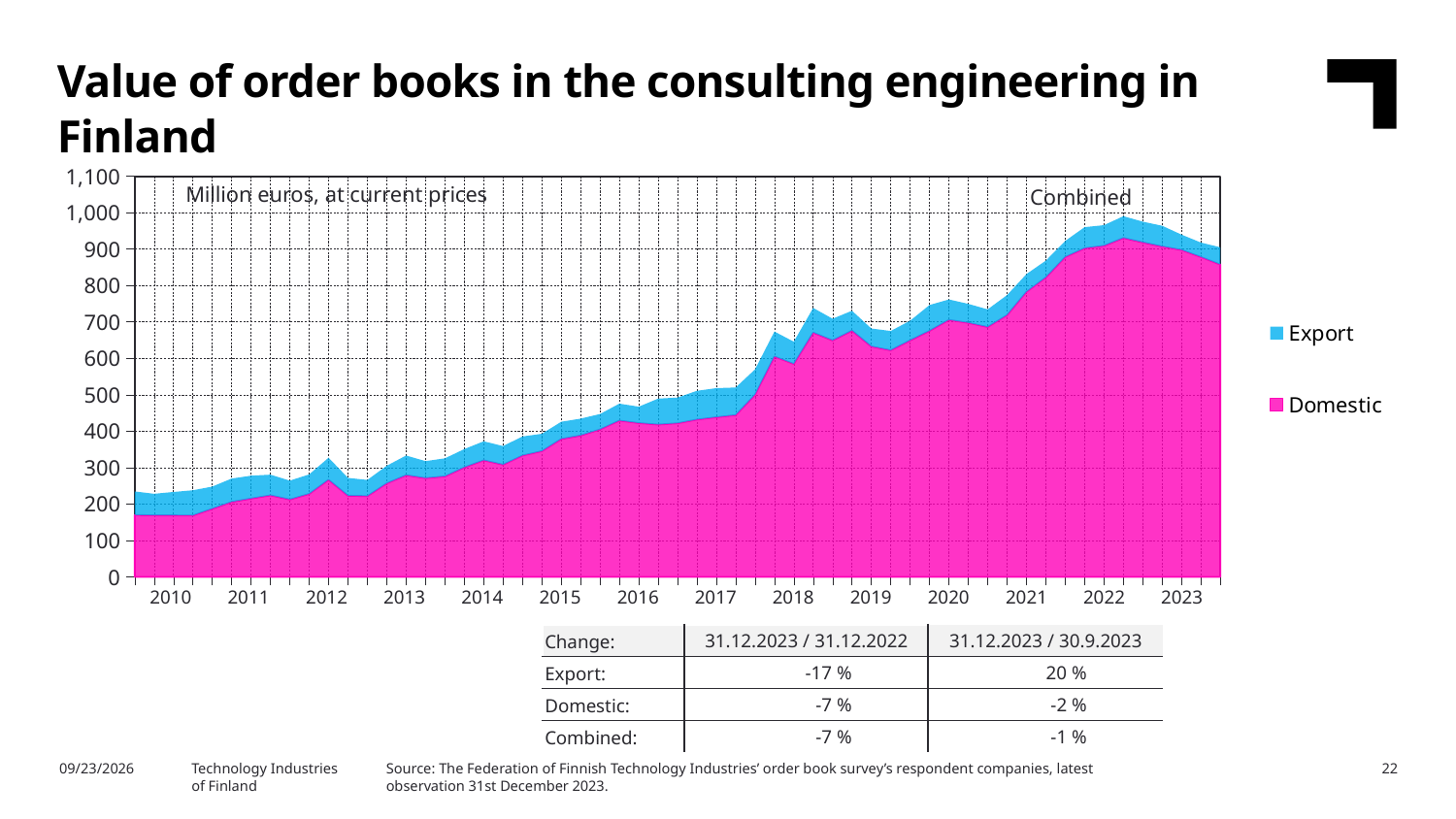
Does the combined value of order books generally rise or fall from 2010 to 2022? Rise Is the combined value at the start of 2010 greater or less than 300? less Is the peak combined value in 2022 greater or less than 900? greater Is the Domestic value at the start of 2010 greater or less than 200? less In which year does the combined value of order books reach its highest point? 2022 How many years are labelled on the x axis? 14 What unit is stated for the values in the chart? Million euros, at current prices In which year is the combined value of order books at its lowest? 2010 How many series does the legend list? 2 What kind of chart is shown on the slide? Stacked area chart Which two series are listed in the legend? Export and Domestic